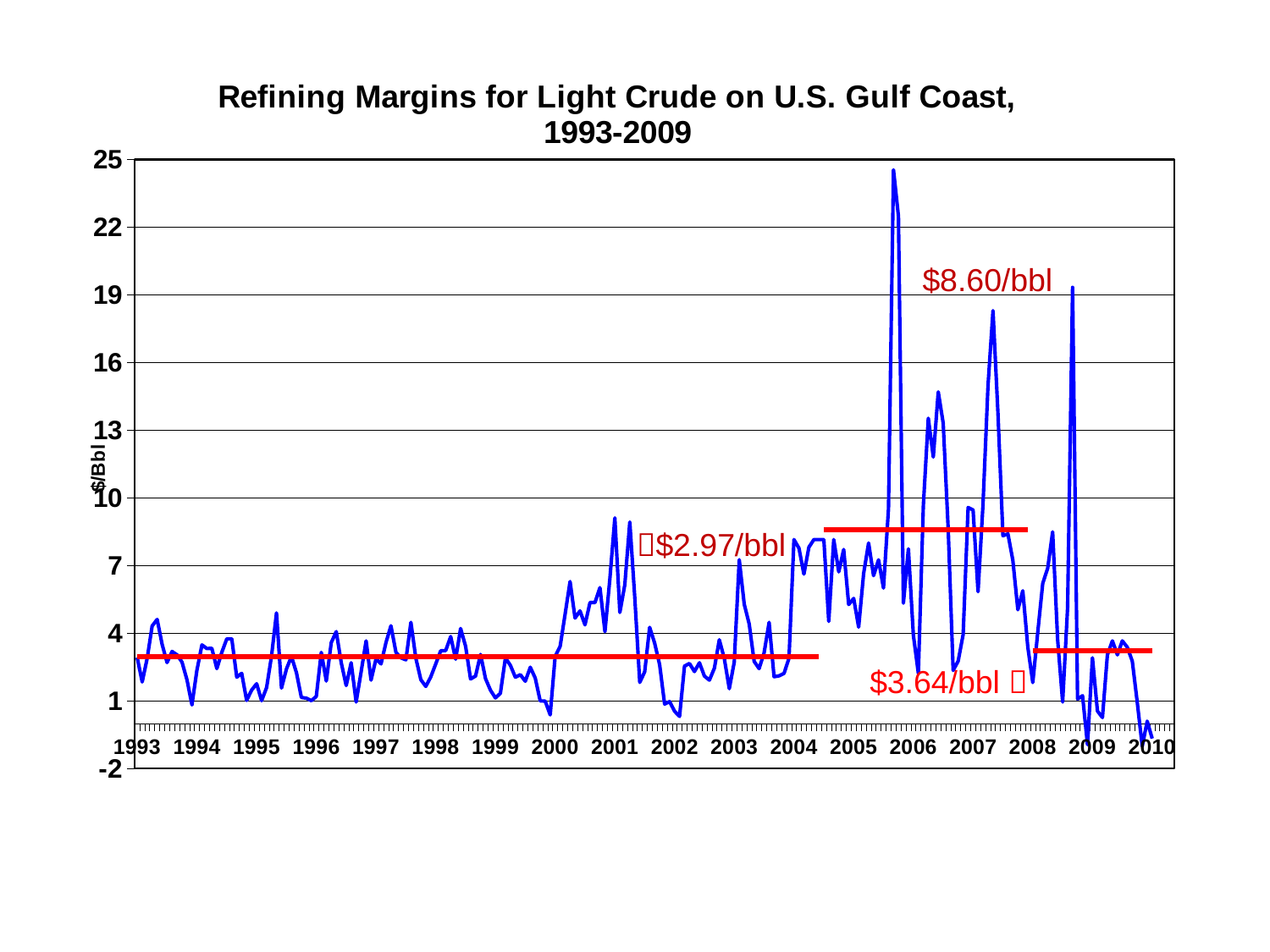
What is the average refining margin annotated for the period from 1993 to 2004? $2.97/bbl How many red horizontal average lines are drawn on the chart? 3 What is the average refining margin annotated for the period from 2005 to 2007? $8.60/bbl Which of the three annotated period averages is the highest? $8.60/bbl What is the difference between the $8.60/bbl average and the $3.64/bbl average? $4.96/bbl Is the highest peak of the refining margin line, reached around late 2005, greater or less than 22? greater What is the average refining margin annotated for the period from 2008 to 2009? $3.64/bbl What is the label on the vertical axis? $/Bbl What is the difference between the $8.60/bbl average and the $2.97/bbl average? $5.63/bbl What is the title of the chart? Refining Margins for Light Crude on U.S. Gulf Coast, 1993-2009 What kind of chart is shown on the slide? line chart Which of the three annotated period averages is the lowest? $2.97/bbl